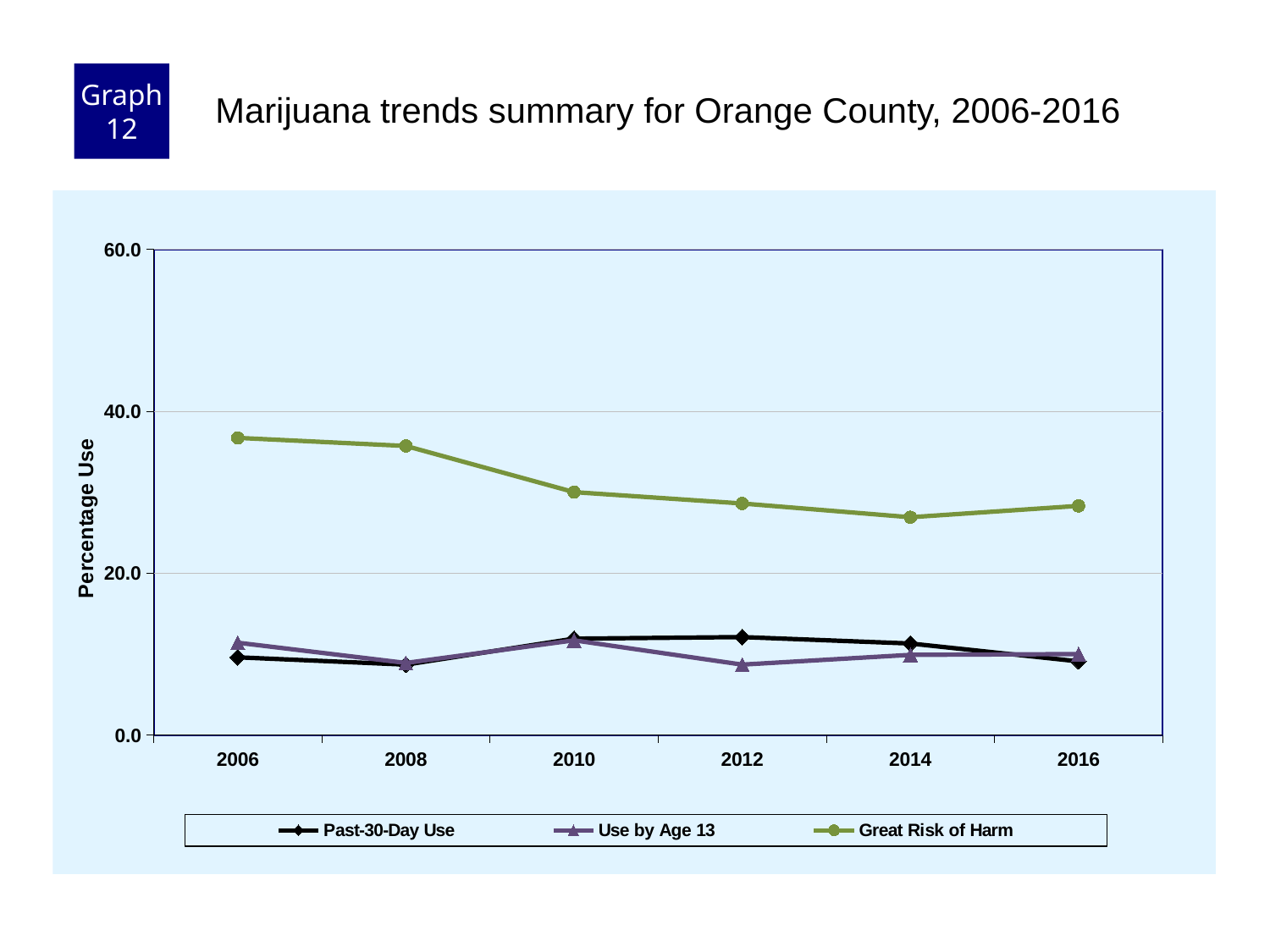
Is the value for Past-30-Day Use in 2012 greater or less than 20.0? less How many years are plotted along the x axis? 6 How many series does the legend list? 3 Is the value for Great Risk of Harm in 2006 greater or less than 20.0? greater Which series has the highest value in 2010? Great Risk of Harm In 2010, which is larger: Great Risk of Harm or Use by Age 13? Great Risk of Harm Does the Great Risk of Harm line rise or fall from 2006 to 2014? fall Is the value for Great Risk of Harm in 2014 greater or less than 40.0? less What is the title of the chart? Marijuana trends summary for Orange County, 2006-2016 What kind of chart is shown on the slide? line chart What is the label on the y axis? Percentage Use